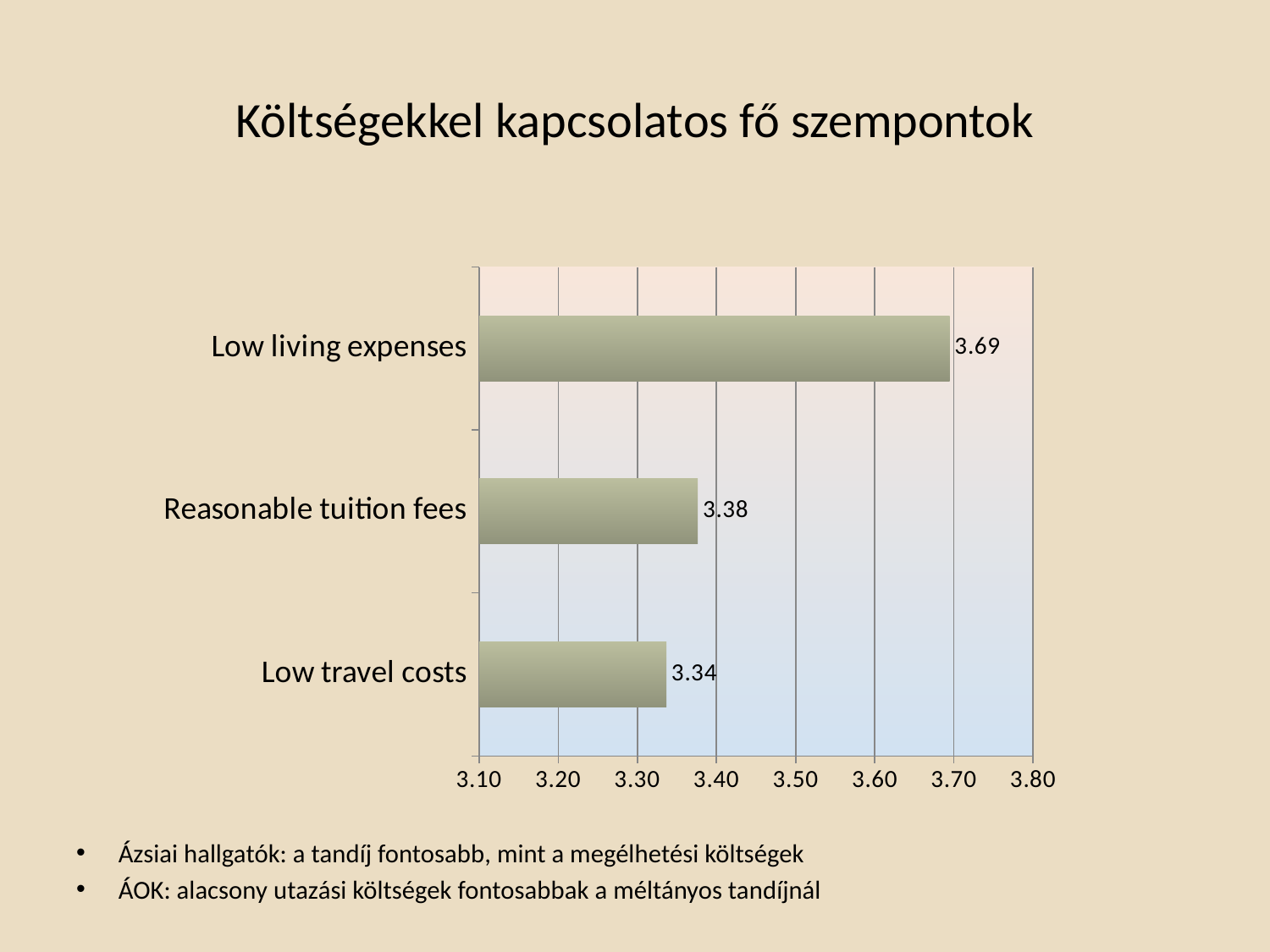
How many categories are shown in the chart? 3 What is the difference between the values for Reasonable tuition fees and Low travel costs? 0.04 What is the value for Low living expenses? 3.69 What is the difference between the values for Low living expenses and Reasonable tuition fees? 0.31 Which category has the lowest value? Low travel costs Which category has the highest value? Low living expenses What is the value for Low travel costs? 3.34 Which is larger, the value for Low living expenses or the value for Low travel costs? Low living expenses What is the value for Reasonable tuition fees? 3.38 Is the value for Low living expenses greater or less than 3.60? greater What kind of chart is shown on the slide? bar chart What is the title of the slide containing the chart? Költségekkel kapcsolatos fő szempontok